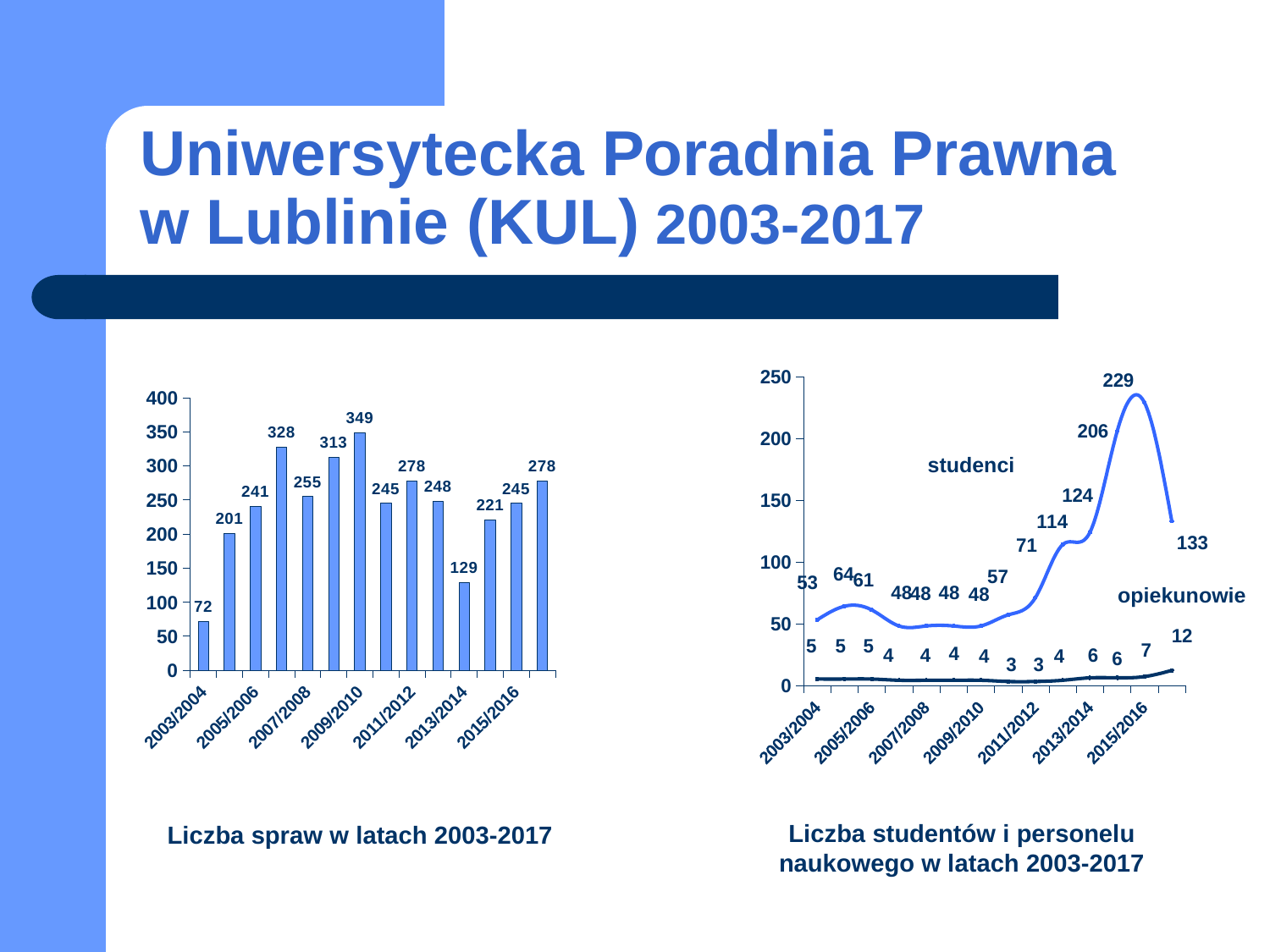
In the left chart 'Liczba spraw w latach 2003-2017', what is the value for 2003/2004? 72 In the left chart 'Liczba spraw w latach 2003-2017', what is the value for 2013/2014? 129 What kind of chart is the right chart, 'Liczba studentów i personelu naukowego w latach 2003-2017'? line chart In the left chart 'Liczba spraw w latach 2003-2017', what is the difference between the highest value (349) and the lowest value (72)? 277 How many series are plotted in the right chart 'Liczba studentów i personelu naukowego w latach 2003-2017'? 2 In the left chart 'Liczba spraw w latach 2003-2017', how many bars are plotted? 14 In the left chart 'Liczba spraw w latach 2003-2017', which is larger: the value for 2003/2004 or the value for 2013/2014? 2013/2014 In the left chart 'Liczba spraw w latach 2003-2017', what is the lowest value shown? 72 In the right chart 'Liczba studentów i personelu naukowego w latach 2003-2017', what is the highest value of the 'studenci' series? 229 In the left chart 'Liczba spraw w latach 2003-2017', what is the highest value shown? 349 What kind of chart is the left chart, 'Liczba spraw w latach 2003-2017'? bar chart In the right chart 'Liczba studentów i personelu naukowego w latach 2003-2017', what is the highest value of the 'opiekunowie' series? 12